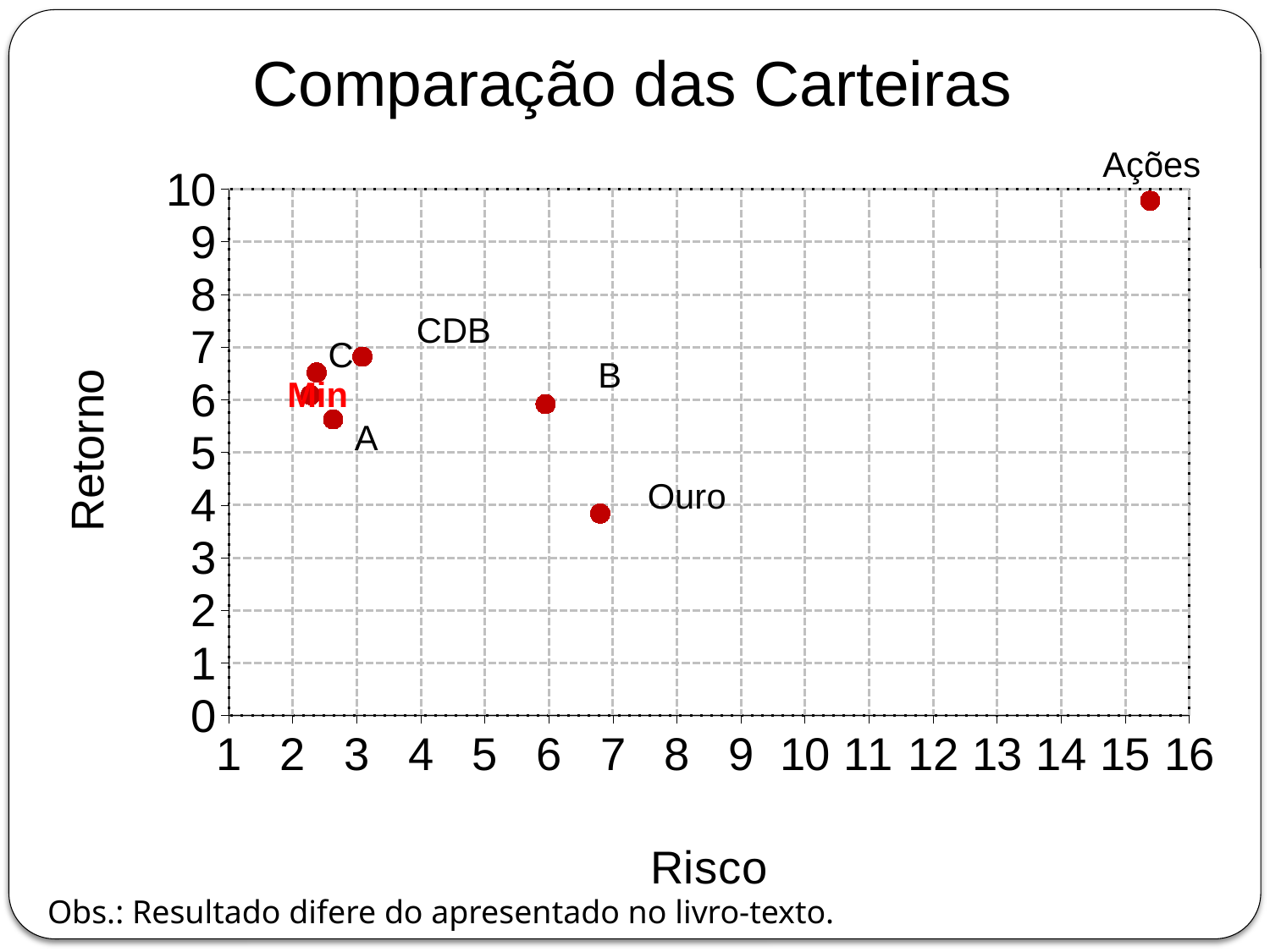
What is the label of the vertical axis? Retorno Which point has the highest Risco? Ações Is the Retorno for Ações greater or less than 9? greater Is the Retorno for CDB greater or less than 6? greater Which has a higher Retorno, B or Ouro? B Which point has the highest Retorno? Ações Which point has the lowest Retorno? Ouro What is the title of the chart? Comparação das Carteiras Is the Risco for B greater or less than 7? less What kind of chart is shown on the slide? scatter chart